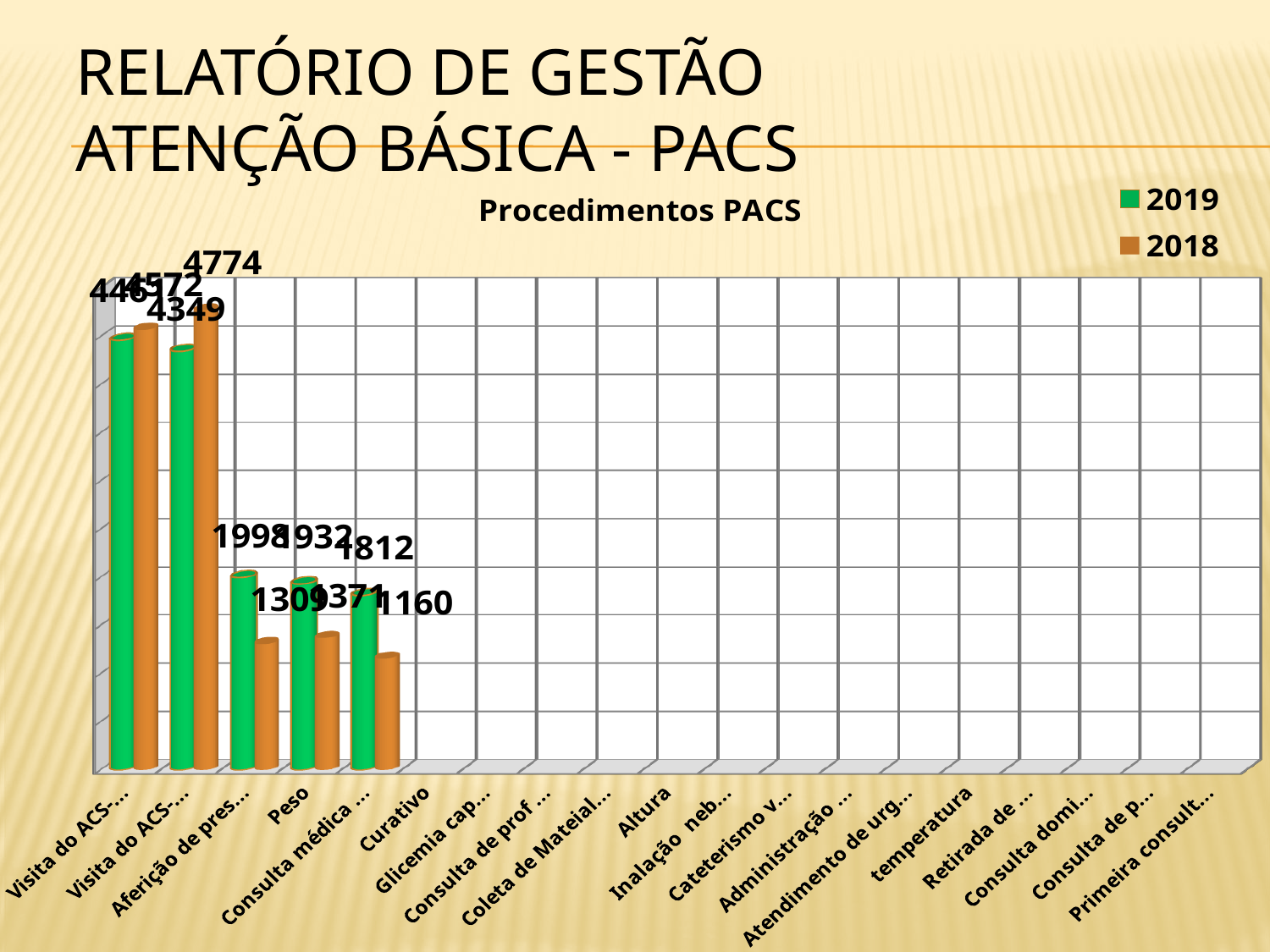
What is the difference between the 2019 and 2018 values for Consulta médica? 652 For Peso, which year has the larger value, 2019 or 2018? 2019 What is the 2018 value for Peso? 1371 What is the 2018 value for Consulta médica? 1160 What is the 2018 value for the second 'Visita do ACS...' category? 4774 What is the title of the chart? Procedimentos PACS How many categories are shown on the x axis? 19 What is the highest value labelled on the chart? 4774 What is the 2019 value for Consulta médica? 1812 How many series does the legend list? 2 Which colour represents the 2019 series in the legend? green What kind of chart is shown on the slide? bar chart